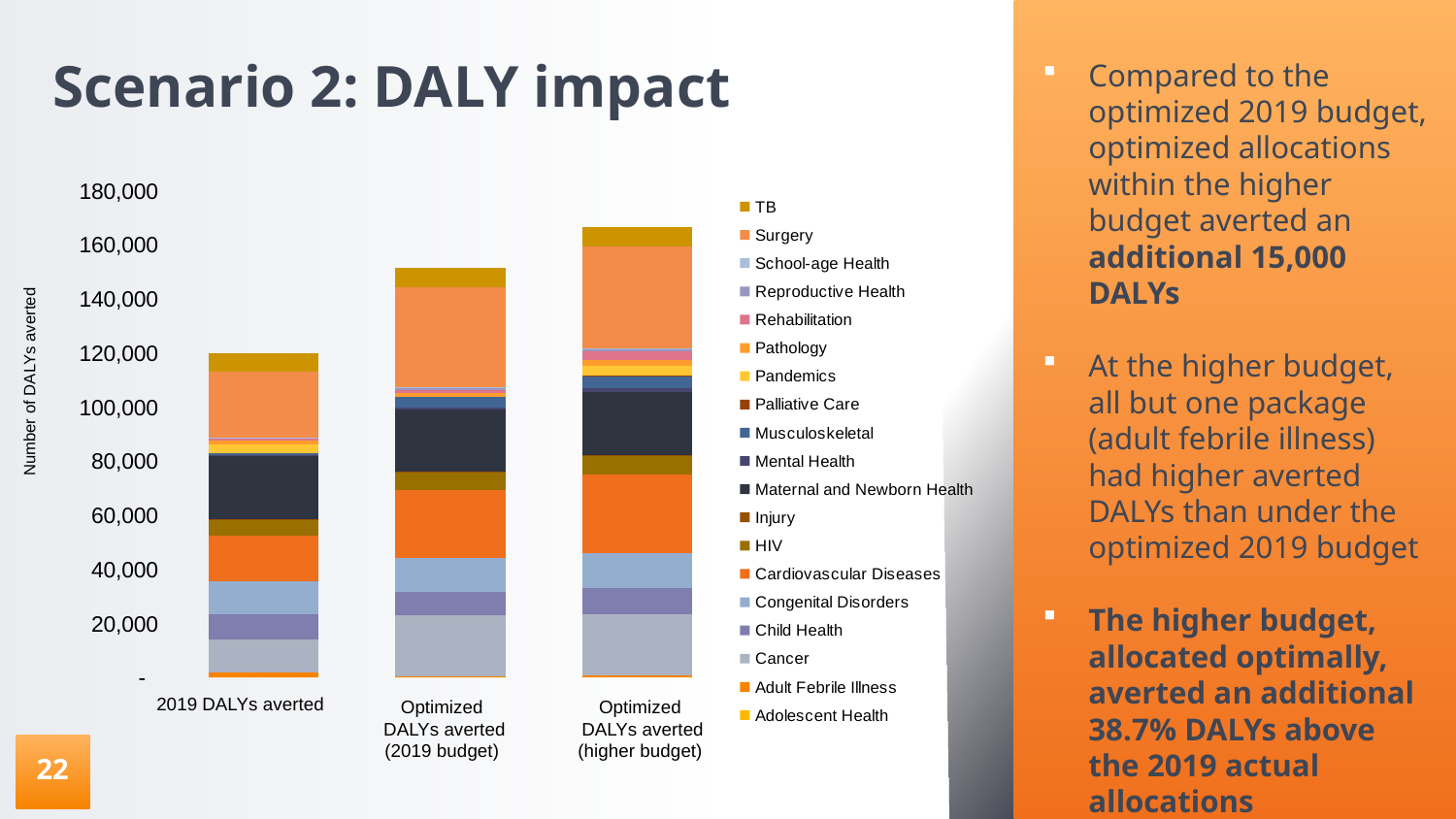
Which bar has the highest total number of DALYs averted? Optimized DALYs averted (higher budget) How many bars (categories) are plotted on the x axis of the chart? 3 What is the label on the chart's vertical axis? Number of DALYs averted Which bar has the lowest total number of DALYs averted? 2019 DALYs averted Which bar is taller: 'Optimized DALYs averted (2019 budget)' or '2019 DALYs averted'? Optimized DALYs averted (2019 budget) Is the total for the 'Optimized DALYs averted (higher budget)' bar greater or less than 160,000? greater Is the total for the '2019 DALYs averted' bar greater or less than 100,000? greater Is the total for the '2019 DALYs averted' bar greater or less than 140,000? less Do the bar totals rise or fall from left to right across the x axis? Rise How many series does the chart's legend list? 19 What kind of chart is shown on the slide? Stacked bar chart